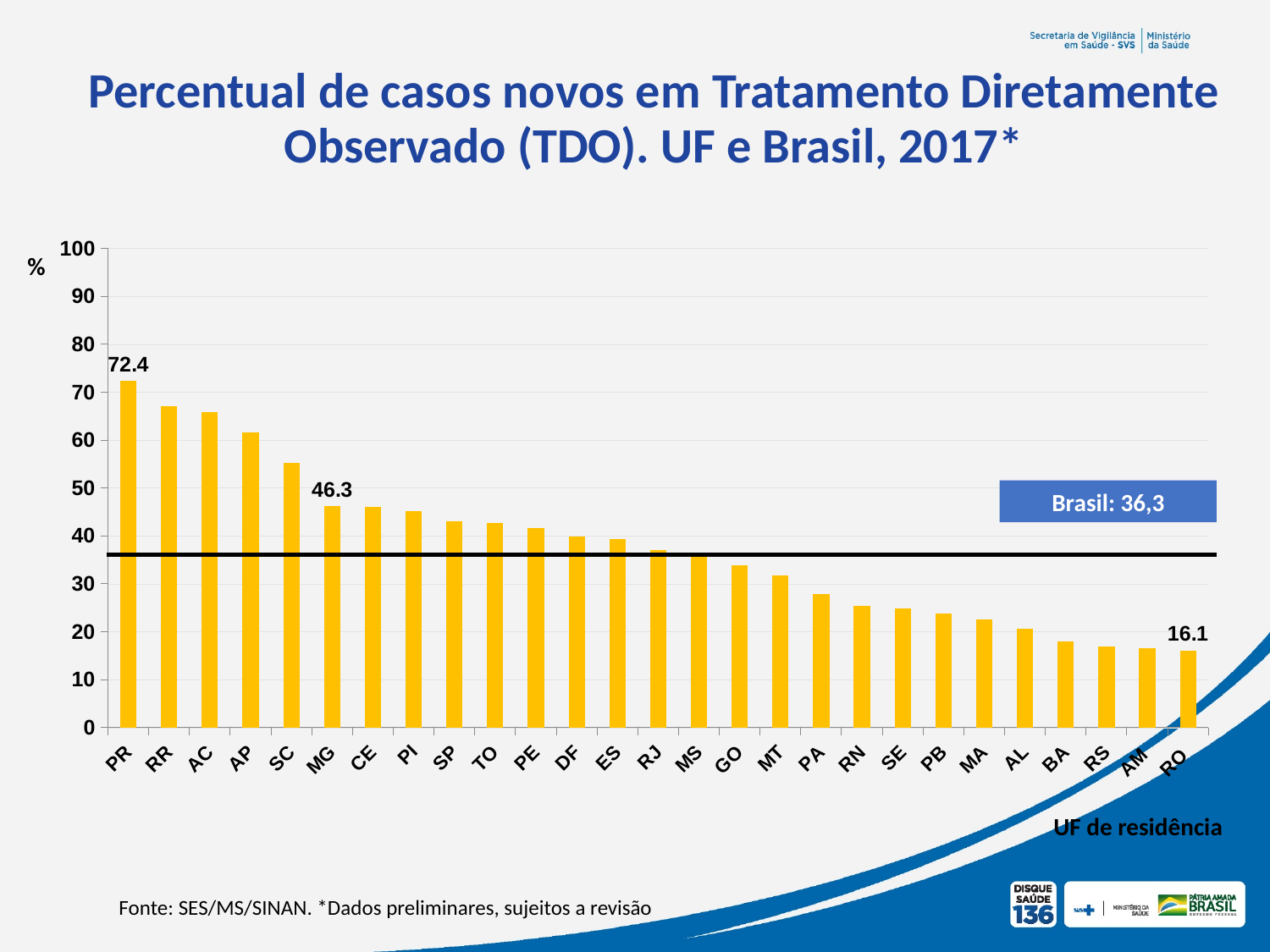
What is the value for RO? 16.1 Which UF has the highest percentage? PR What value for Brasil is shown in the box on the chart? 36,3 What is the difference between the values for PR and RO? 56.3 What kind of chart is shown on the slide? bar chart Is the value for GO greater or less than 40? less Which UF has the lowest percentage? RO What is the value for MG? 46.3 What is the difference between the values for PR and MG? 26.1 How many UFs are shown on the x axis? 27 Which has a larger value, SC or MG? SC What is the value for PR? 72.4